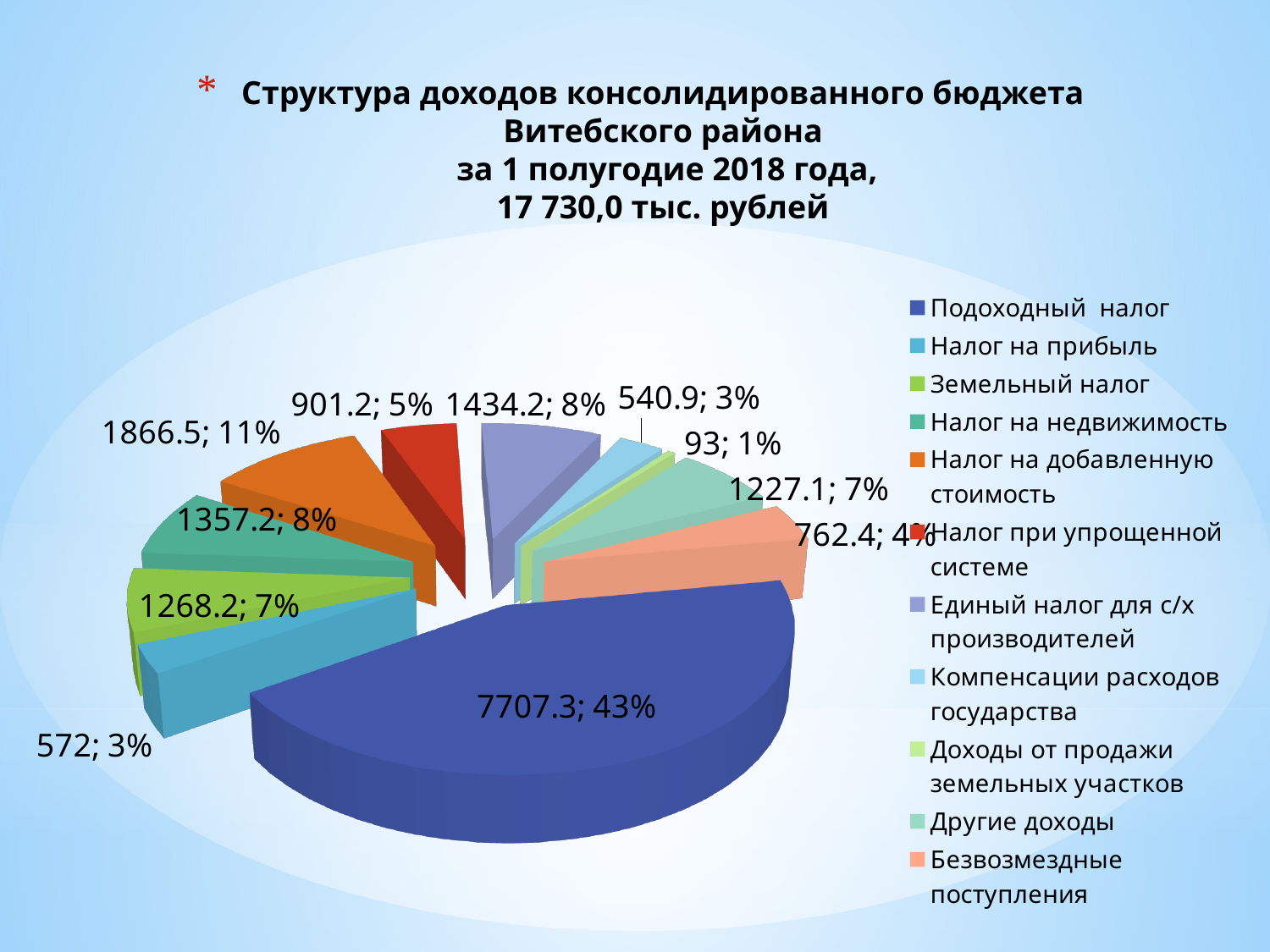
What share of the pie does Налог на добавленную стоимость have? 11% What value is shown for Единый налог для с/х производителей? 1434.2 What value is shown for Компенсации расходов государства? 540.9 How many categories does the legend of the pie chart list? 11 Which is larger, the value for Налог на недвижимость or the value for Земельный налог? Налог на недвижимость What total amount is stated in the chart title? 17 730,0 тыс. рублей Which category has the largest slice in the pie chart? Подоходный налог What kind of chart is shown on the slide? pie chart What share of the pie does Безвозмездные поступления have? 4% Which category has the smallest slice in the pie chart? Доходы от продажи земельных участков What value is shown for Подоходный налог? 7707.3 What is the difference between the value for Налог на добавленную стоимость and the value for Налог при упрощенной системе? 965.3